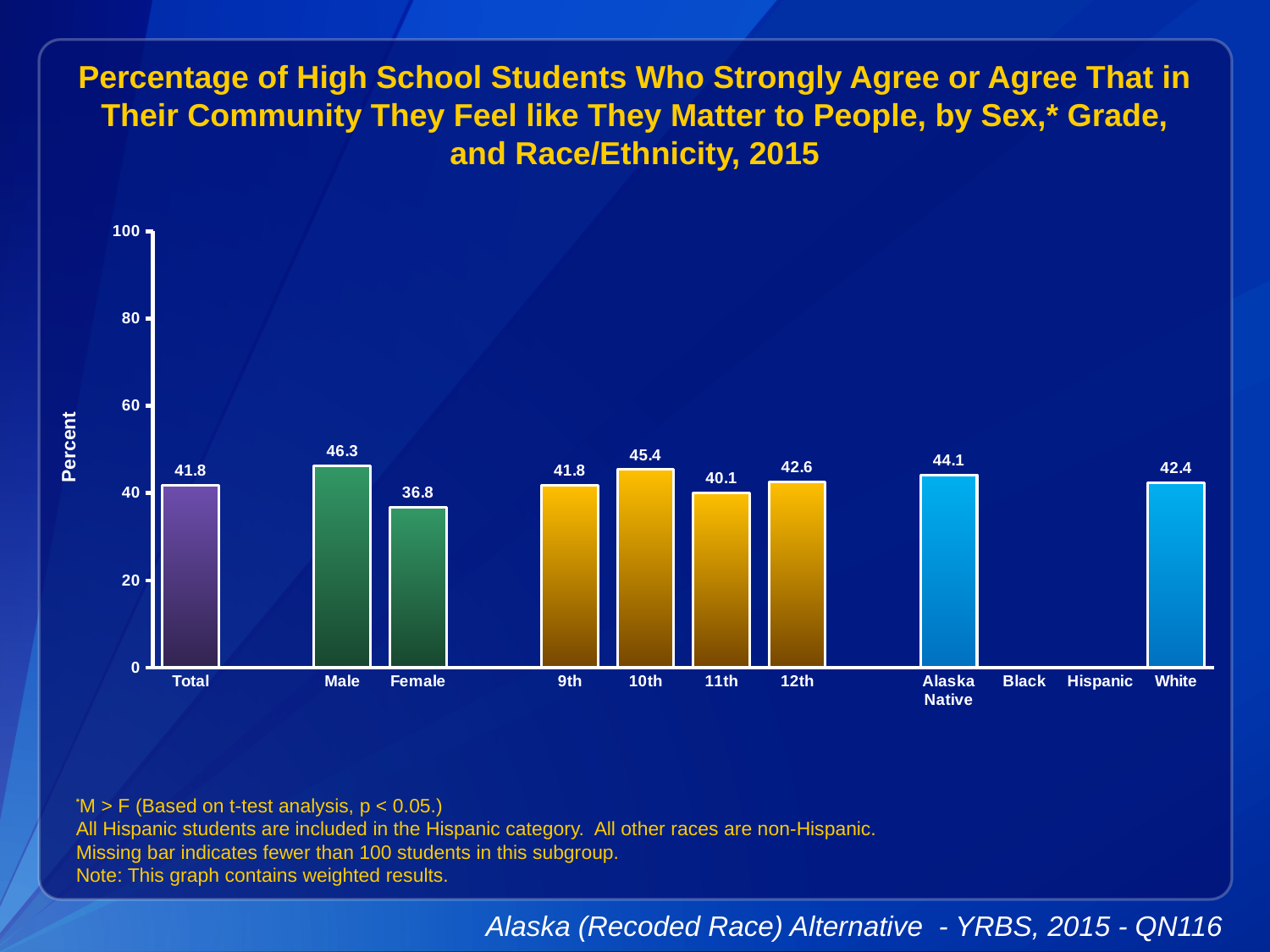
What is the value for Alaska Native? 44.1 Which category has the lowest value? Female Which category has the highest value? Male What is the difference between the Male and Female values? 9.5 What is the value for Male? 46.3 What kind of chart is shown? bar chart What is the value for 11th grade? 40.1 How many bars are plotted on the chart? 9 What is the label of the y axis? Percent Is the value for White greater or less than 60? less Which is larger, the value for 10th grade or 12th grade? 10th What is the value for Female? 36.8